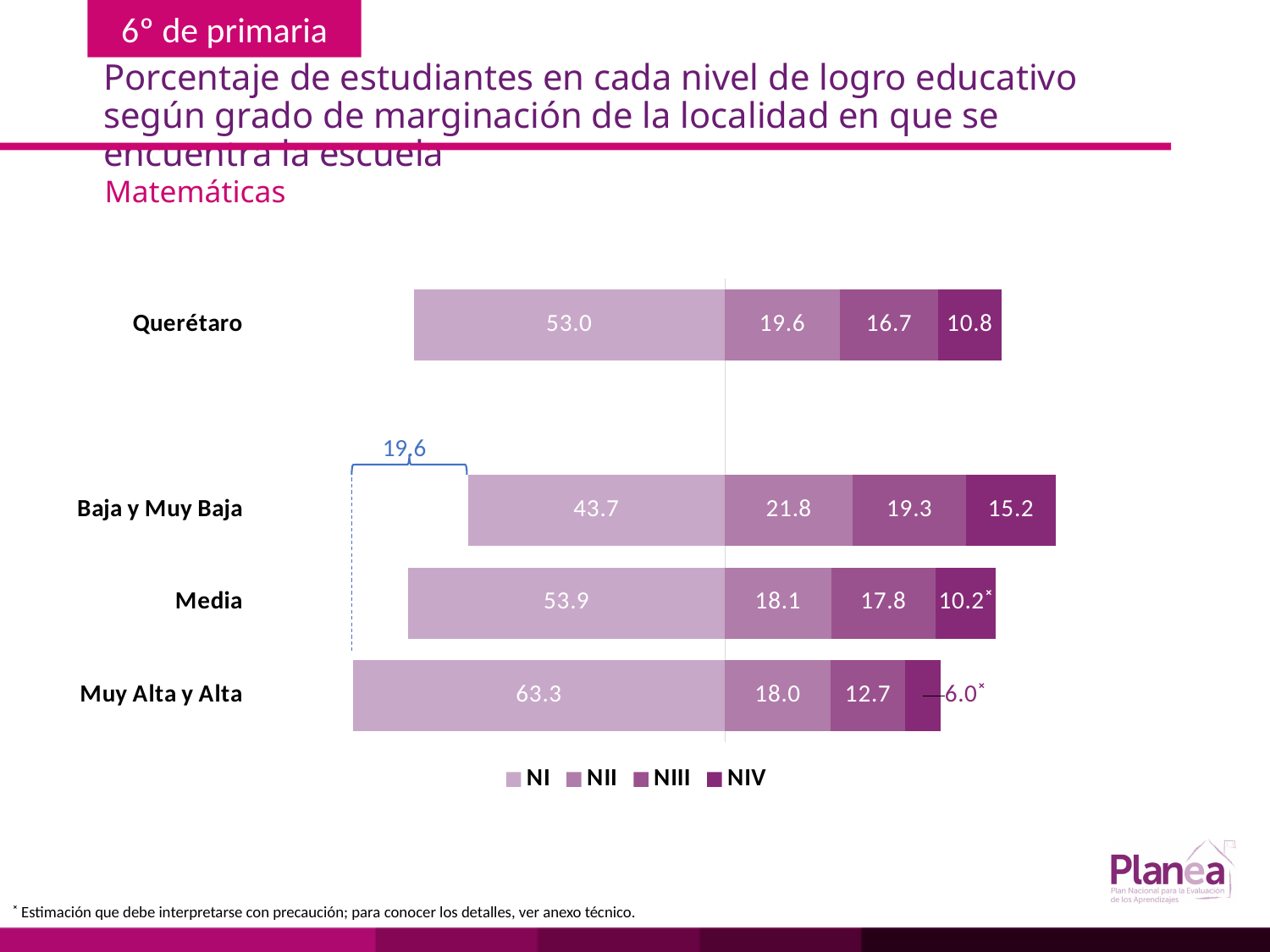
How many categories are plotted on the chart? 4 What is the NIII value for Muy Alta y Alta? 12.7 What is the subject label shown below the chart title? Matemáticas What is the NIV value for Baja y Muy Baja? 15.2 What is the difference between the NI values for Muy Alta y Alta and Baja y Muy Baja? 19.6 What is the NII value for Media? 18.1 Which category has the lowest NIV value? Muy Alta y Alta Which is larger, the NIII value for Baja y Muy Baja or the NIII value for Media? Baja y Muy Baja What type of chart is shown on the slide? stacked bar chart What is the NI value for Querétaro? 53.0 How many series does the legend list? 4 Which category has the highest NI value? Muy Alta y Alta